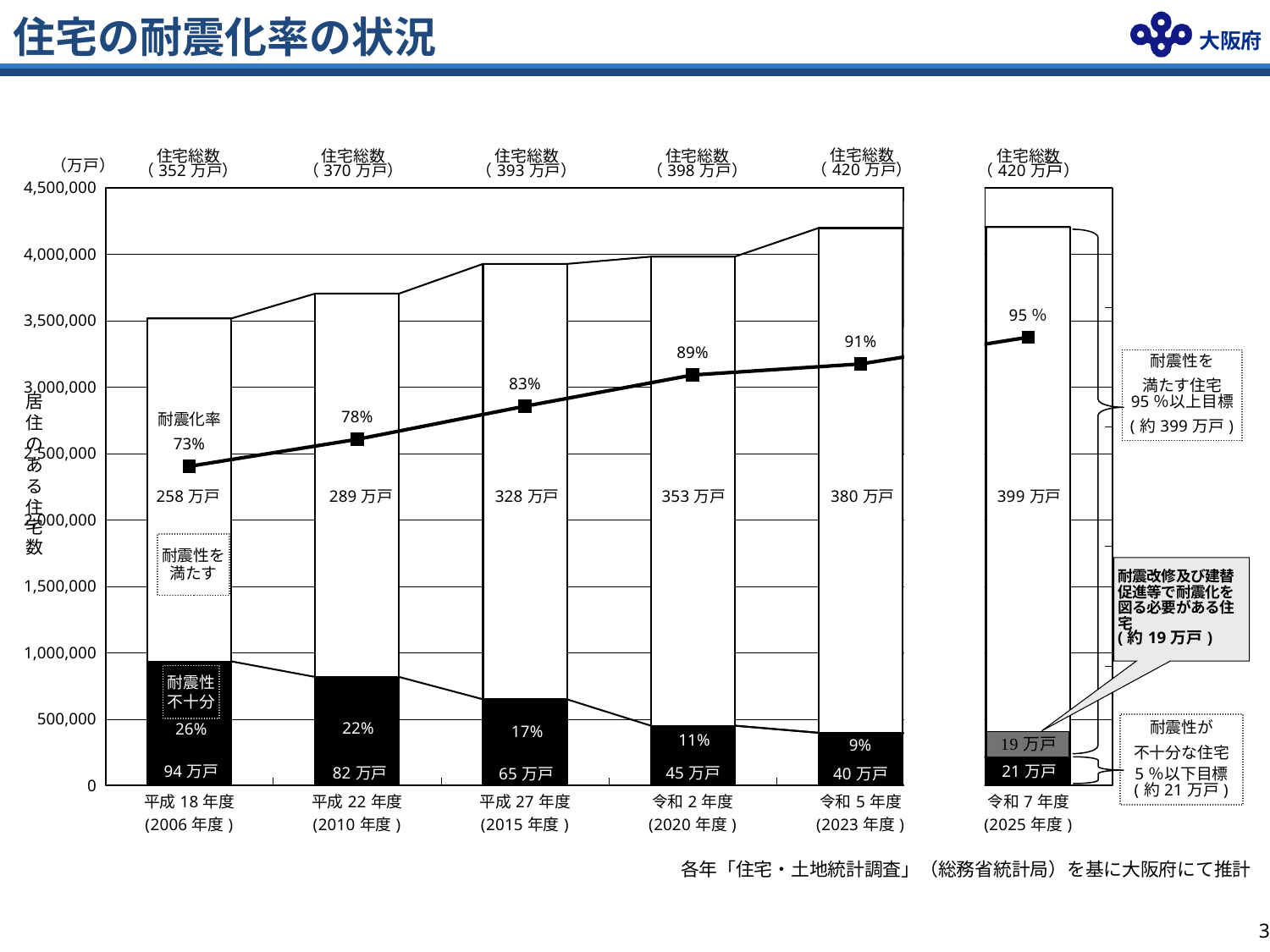
令和7年度（2025年度）の耐震化率の目標値は何%ですか？ 95% 耐震性を満たす住宅数が最も少ないのはどの年度ですか？ 平成18年度（2006年度） 耐震化率は年度が進むにつれて上昇していますか、下降していますか？ 上昇 グラフには何年度分の棒が示されていますか？ 6 令和5年度（2023年度）の耐震性を満たす住宅数は何万戸ですか？ 380万戸 平成27年度（2015年度）の耐震性不十分な住宅数は何万戸ですか？ 65万戸 このグラフはどのような種類のグラフですか？ 積み上げ棒グラフと折れ線グラフの組み合わせ 平成18年度（2006年度）と令和5年度（2023年度）では、耐震性不十分な住宅数はどちらが多いですか？ 平成18年度（2006年度） 令和2年度（2020年度）と平成22年度（2010年度）の耐震化率の差は何ポイントですか？ 11ポイント 耐震性不十分な住宅数が最も多いのはどの年度ですか？ 平成18年度（2006年度） 平成18年度（2006年度）の耐震化率は何%ですか？ 73% 平成22年度（2010年度）の住宅総数は何万戸ですか？ 370万戸